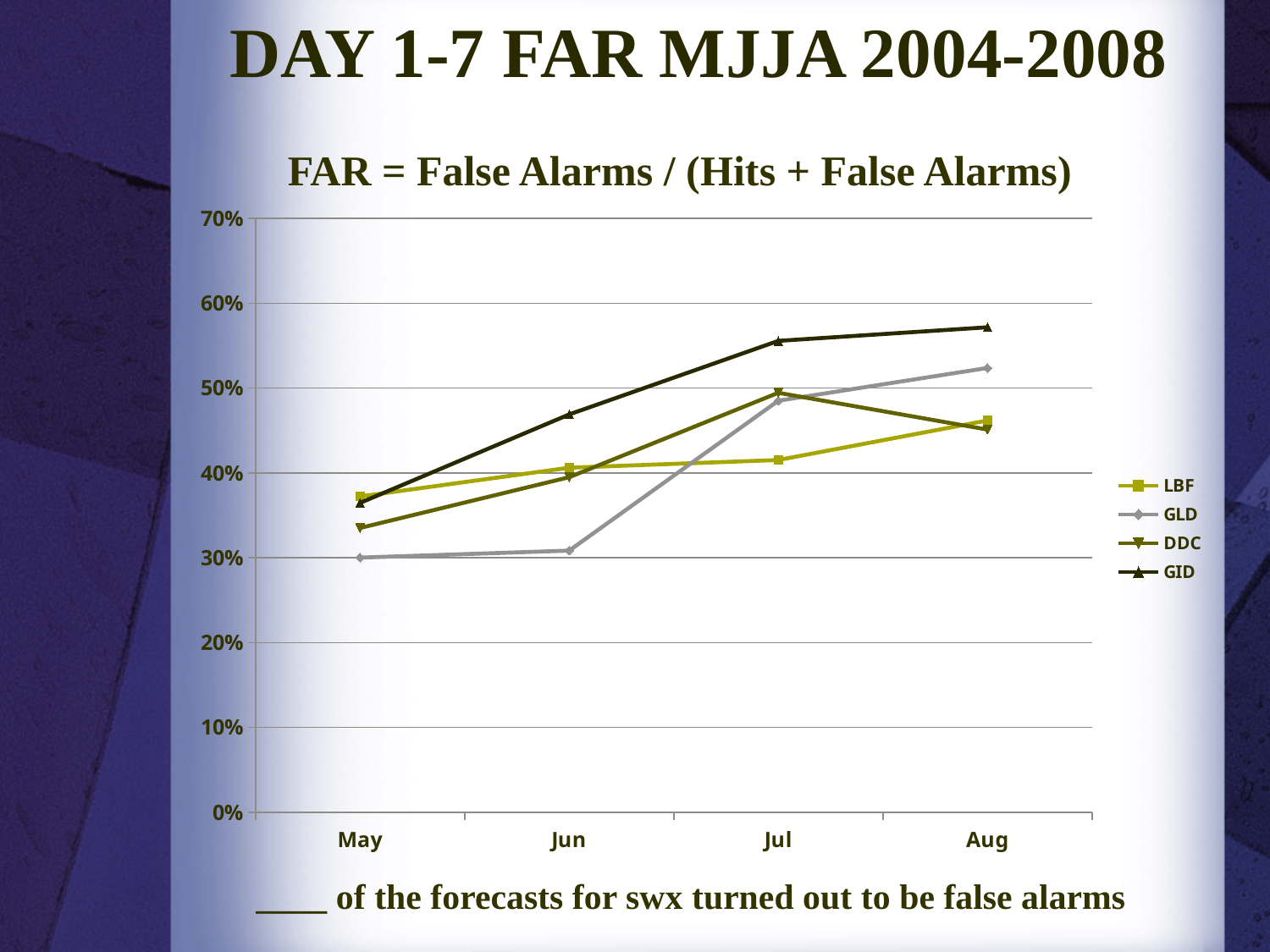
Is the value for GLD in May greater or less than 40%? less Is the value for DDC in May greater or less than 40%? less In Jul, which is larger, the value for DDC or the value for LBF? DDC Which series has the lowest value in May? GLD Does the GID series rise or fall from May to Aug? rise What kind of chart is shown on the slide? line chart Which series has the lowest value in Jun? GLD Is the value for GID in Aug greater or less than 50%? greater Which series has the highest value in Aug? GID What is the title of the chart on the slide? DAY 1-7 FAR MJJA 2004-2008 How many months are shown on the x axis? 4 How many series does the legend list? 4